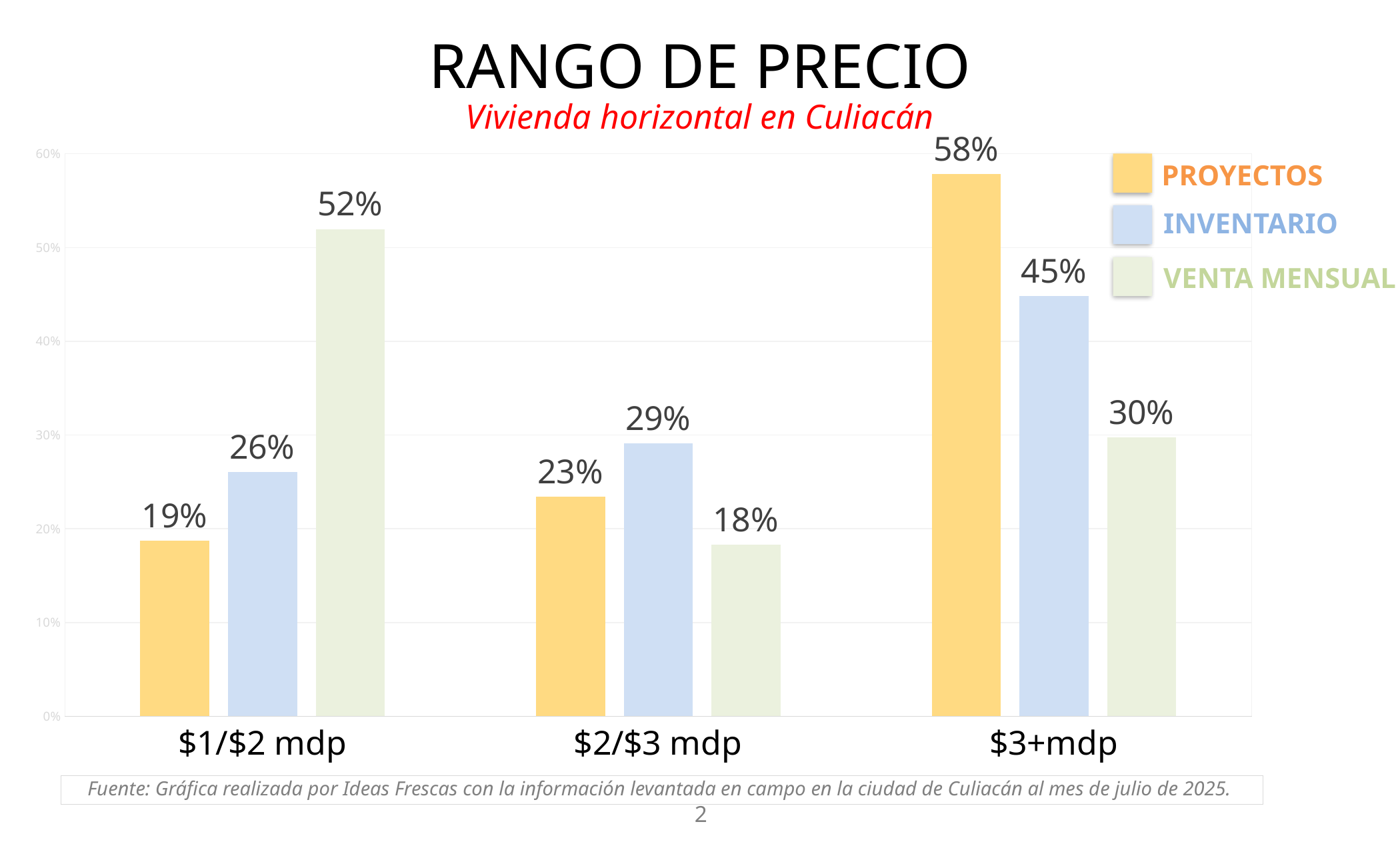
What is the PROYECTOS value for the $1/$2 mdp price range? 19% How many series does the legend list? 3 Which price range has the highest PROYECTOS value? $3+mdp Is the VENTA MENSUAL value for $1/$2 mdp greater or less than 50%? greater How many price range categories are shown on the x axis? 3 What is the VENTA MENSUAL value for the $2/$3 mdp price range? 18% What is the INVENTARIO value for the $3+mdp price range? 45% What kind of chart is shown on the slide? Bar chart Which price range has the lowest VENTA MENSUAL value? $2/$3 mdp Which is larger for the $1/$2 mdp price range: INVENTARIO or VENTA MENSUAL? VENTA MENSUAL What is the title of the chart? RANGO DE PRECIO What is the difference between the PROYECTOS and INVENTARIO values for the $3+mdp price range? 13%